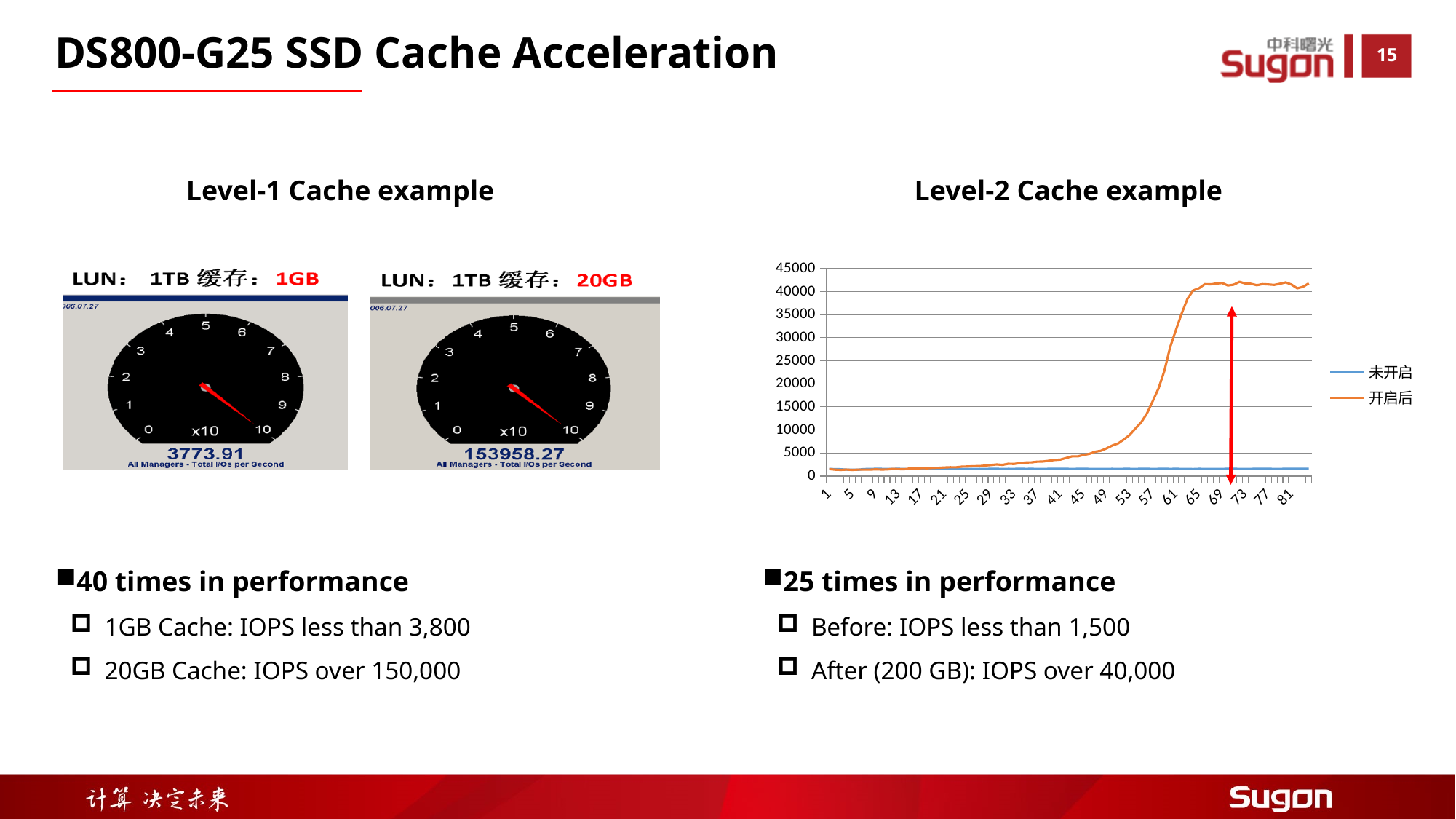
How many series does the legend of the Level-2 Cache example chart list? 2 In the Level-2 Cache example chart, does the 开启后 series rise or fall overall along the x axis? rise In the Level-2 Cache example chart, which series is higher at x = 61, 未开启 or 开启后? 开启后 In the Level-2 Cache example chart, is the value of 开启后 at x = 49 greater or less than 10000? less In the Level-2 Cache example chart, is the value of 开启后 at x = 1 greater or less than 5000? less In the Level-2 Cache example chart, is the value of 开启后 at x = 69 greater or less than 35000? greater What is the highest tick value shown on the y axis of the Level-2 Cache example chart? 45000 In the Level-2 Cache example chart, which series is drawn in orange? 开启后 What kind of chart is shown under "Level-2 Cache example"? line chart What are the two legend entries in the Level-2 Cache example chart? 未开启 and 开启后